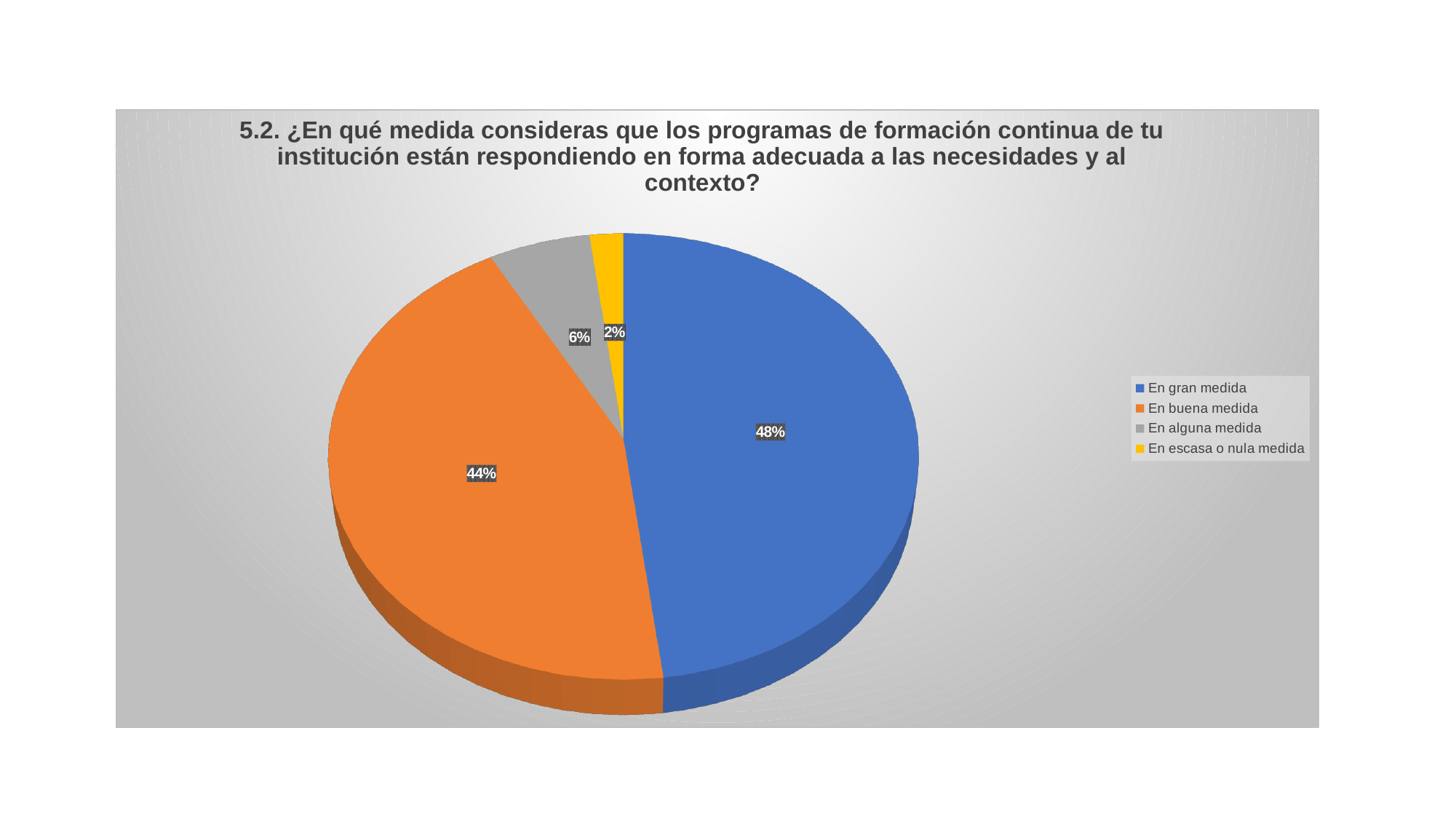
What share of the pie is 'En alguna medida'? 6% What kind of chart is shown on the slide? pie chart Which is larger, the share for 'En alguna medida' or the share for 'En escasa o nula medida'? En alguna medida How many categories does the pie chart have? 4 What share of the pie is 'En buena medida'? 44% What share of the pie is 'En gran medida'? 48% What is the combined share of 'En alguna medida' and 'En escasa o nula medida'? 8% Which category has the largest slice of the pie? En gran medida What colour is the slice for 'En buena medida'? orange Which category has the smallest slice of the pie? En escasa o nula medida What is the difference in percentage points between 'En gran medida' and 'En buena medida'? 4